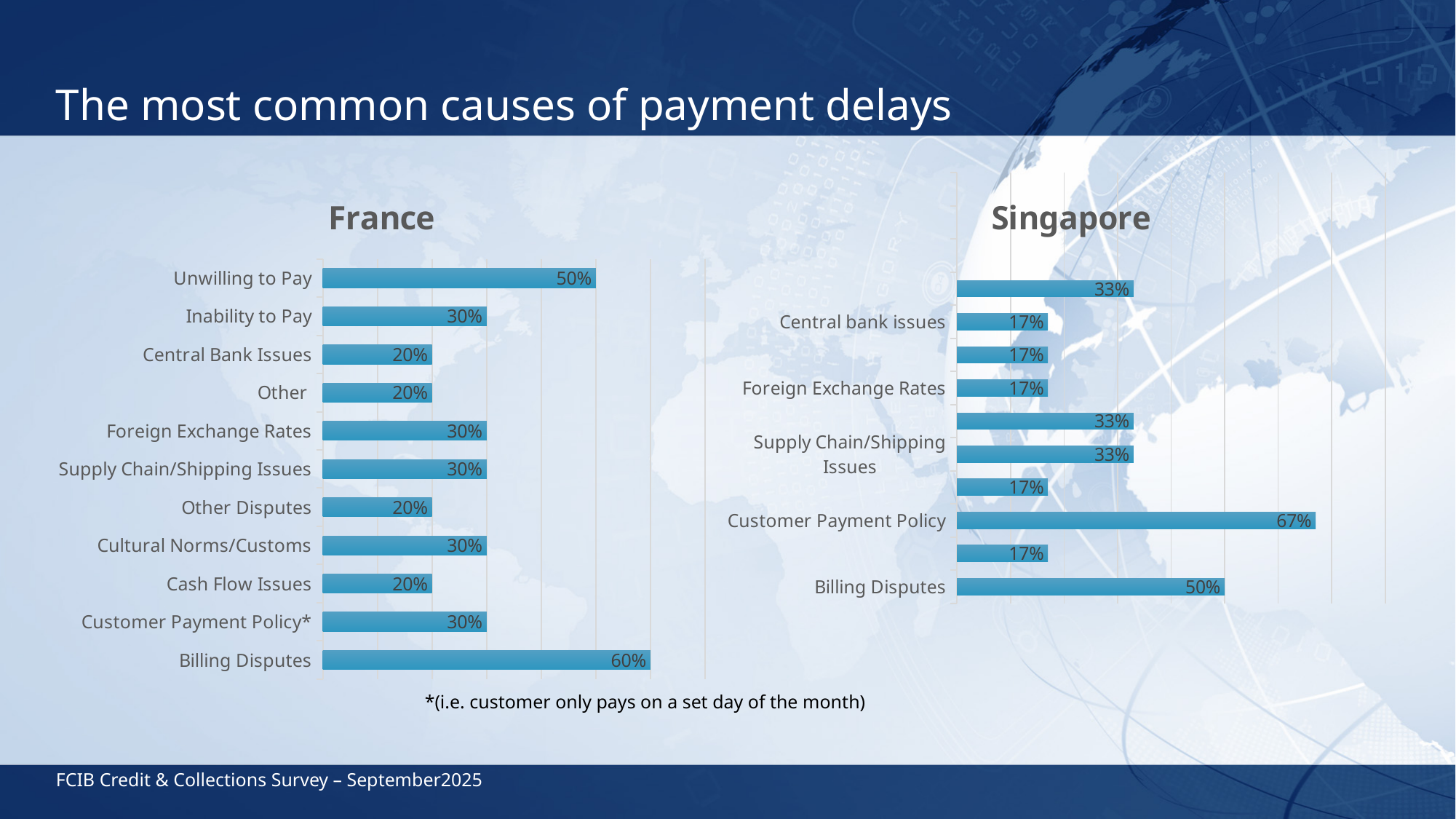
In the France chart, what is the value for Unwilling to Pay? 50% In the France chart, what is the value for Billing Disputes? 60% In the Singapore chart, what is the value for Customer Payment Policy? 67% In the France chart, which cause has the highest value? Billing Disputes In the Singapore chart, what is the value for Billing Disputes? 50% What is the title of the slide? The most common causes of payment delays In the France chart, which is larger, Inability to Pay or Cash Flow Issues? Inability to Pay In the Singapore chart, which cause has the highest value? Customer Payment Policy How many causes are listed in the France chart? 11 What kind of chart is the Singapore chart? Bar chart In the Singapore chart, what is the difference between Customer Payment Policy and Central bank issues? 50% In the France chart, what is the difference between Billing Disputes and Unwilling to Pay? 10%